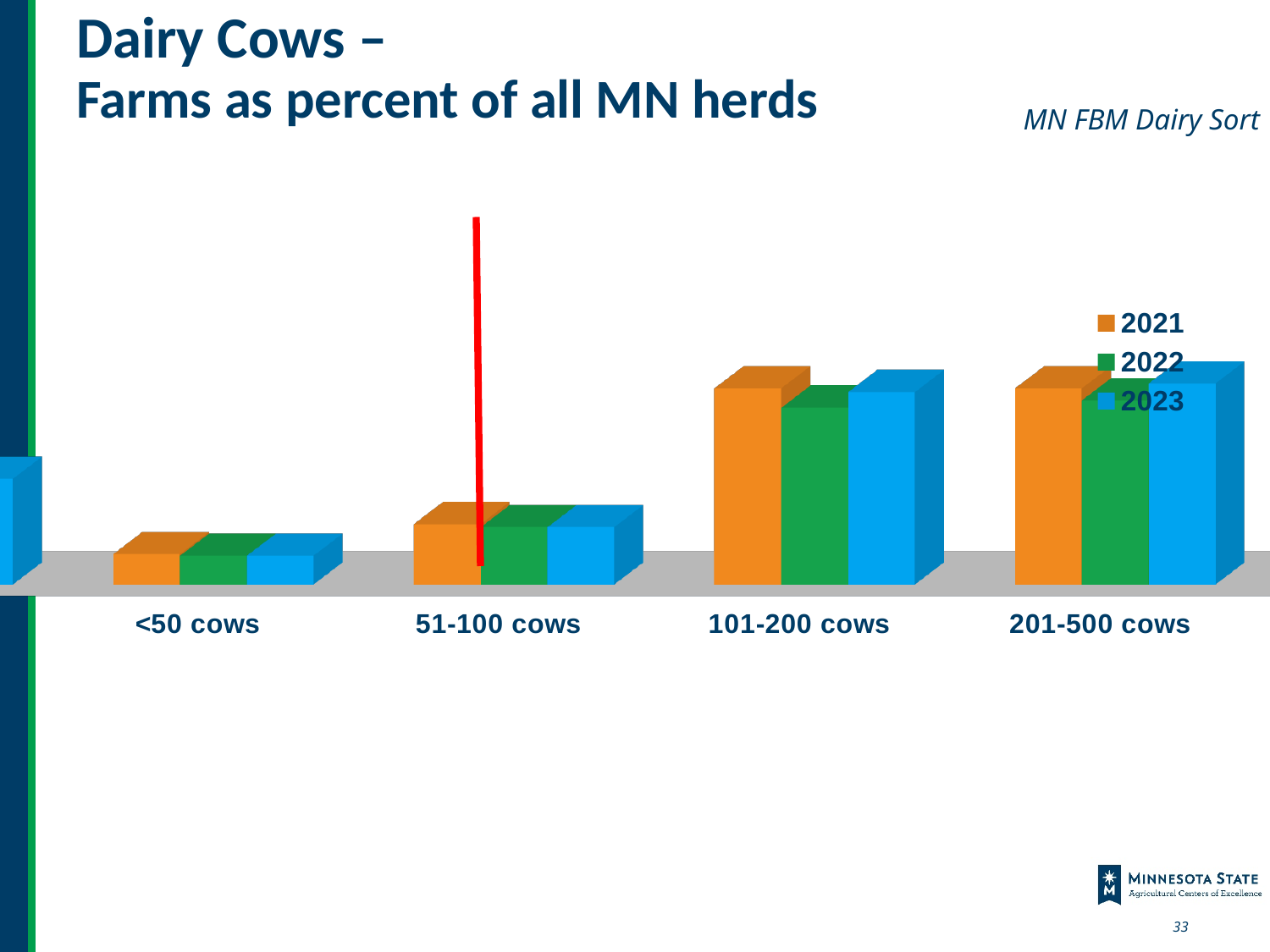
How many series does the legend list? 3 What are the series listed in the legend? 2021, 2022, 2023 Which is larger, the 2023 value for <50 cows or the 2023 value for 101-200 cows? 101-200 cows For 201-500 cows, which is larger, the 2022 value or the 2023 value? 2023 What kind of chart is shown on the slide? Bar chart How many herd-size categories are shown on the x axis? 4 Which herd-size category has the lowest bars? <50 cows Do the 2023 values rise or fall moving from <50 cows to 201-500 cows along the x axis? Rise Which herd-size category has the tallest bar? 201-500 cows Which is larger, the 2021 value for <50 cows or the 2021 value for 51-100 cows? 51-100 cows What is the title of the slide containing the chart? Dairy Cows – Farms as percent of all MN herds